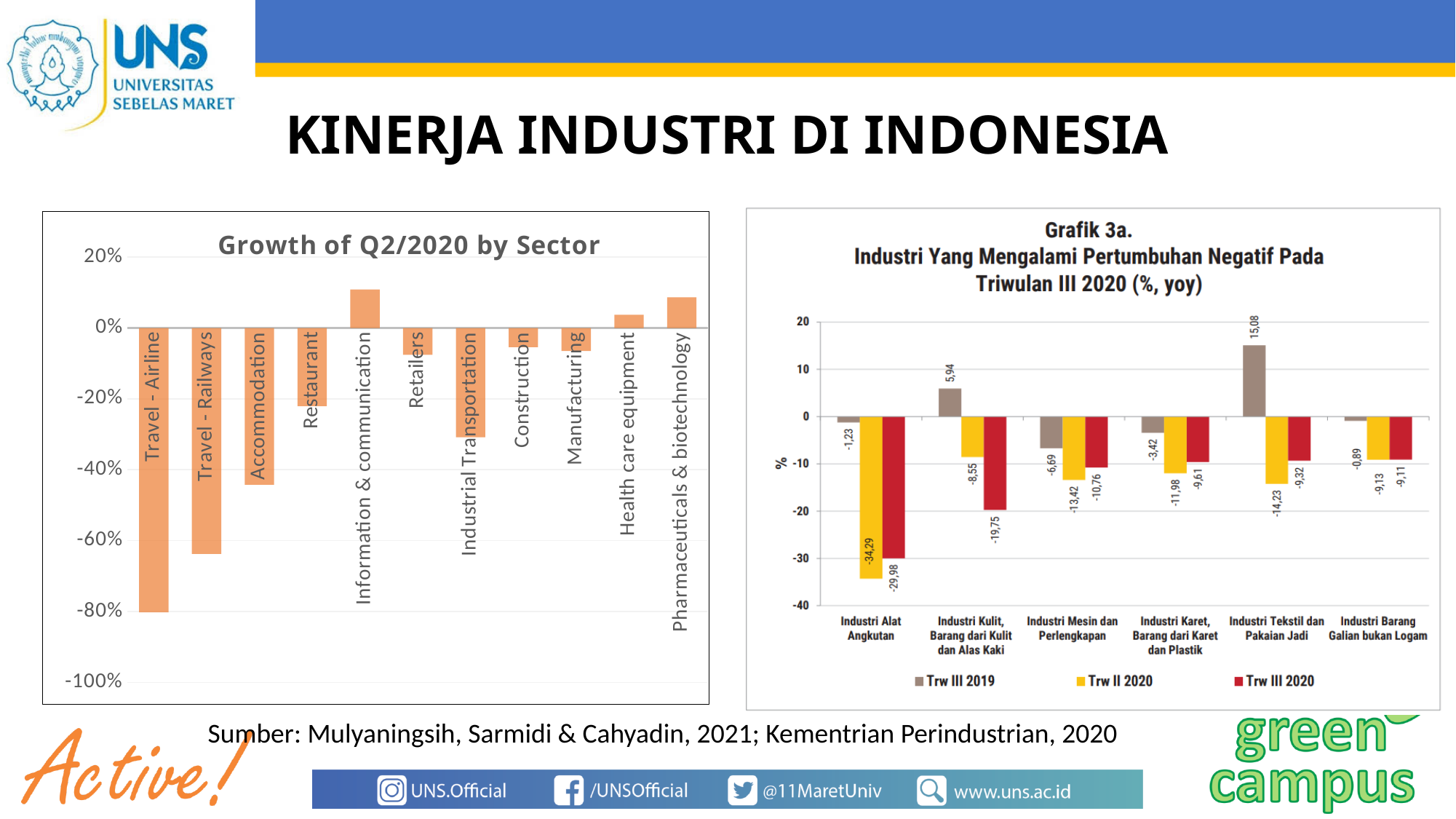
In the 'Growth of Q2/2020 by Sector' chart, is the value for Accommodation greater or less than -40%? less In 'Grafik 3a', what is the difference between the Trw II 2020 and Trw III 2020 values for Industri Kulit, Barang dari Kulit dan Alas Kaki? 11,20 In 'Grafik 3a', which industry has the lowest Trw III 2020 value? Industri Alat Angkutan In the 'Growth of Q2/2020 by Sector' chart, is the value for Travel - Railways greater or less than -60%? less In the 'Growth of Q2/2020 by Sector' chart, which sector has the highest growth? Information & communication In the 'Growth of Q2/2020 by Sector' chart, how many sectors are plotted? 11 In 'Grafik 3a', what is the Trw II 2020 value for Industri Alat Angkutan? -34,29 In the 'Growth of Q2/2020 by Sector' chart, which sector has the lowest growth? Travel - Airline What kind of chart is 'Grafik 3a' on the right of the slide? Bar chart In the 'Growth of Q2/2020 by Sector' chart, which is larger, the value for Restaurant or the value for Industrial Transportation? Restaurant In 'Grafik 3a', how many series does the legend list? 3 In 'Grafik 3a', what is the Trw III 2019 value for Industri Tekstil dan Pakaian Jadi? 15,08